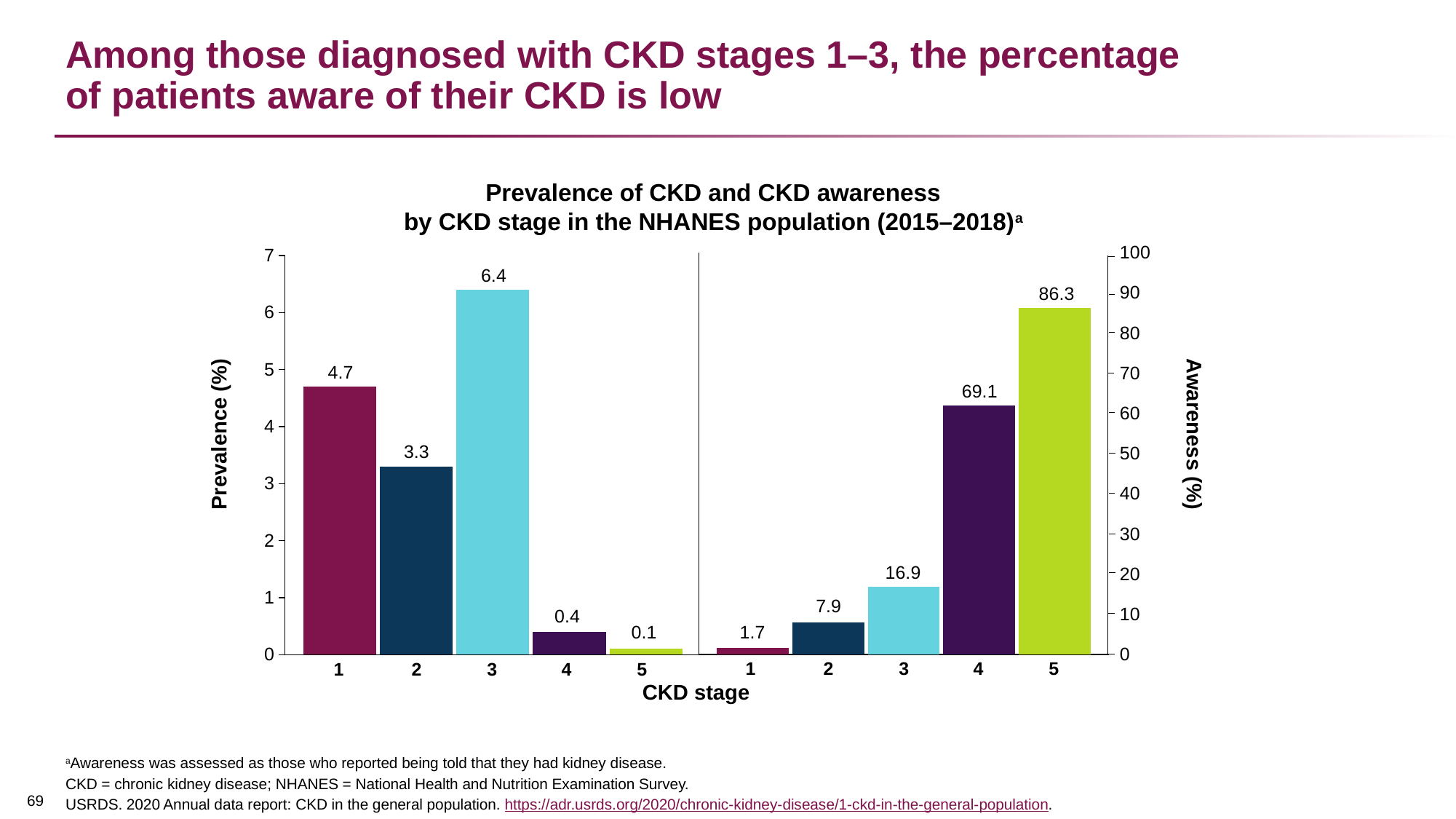
What is the difference in awareness (%) between CKD stage 5 and CKD stage 4? 17.2 Do the awareness (%) values rise or fall as the CKD stage increases from 1 to 5? rise Which CKD stage has the highest prevalence (%)? 3 What is the awareness (%) for CKD stage 5? 86.3 What is the awareness (%) for CKD stage 1? 1.7 Which CKD stage has the highest awareness (%)? 5 Which has a higher prevalence (%), CKD stage 1 or CKD stage 2? CKD stage 1 What is the difference in prevalence (%) between CKD stage 3 and CKD stage 1? 1.7 What is the prevalence (%) for CKD stage 3? 6.4 What type of chart is shown on the slide? bar chart How many CKD stages are shown in the prevalence panel of the chart? 5 Which CKD stage has the lowest prevalence (%)? 5